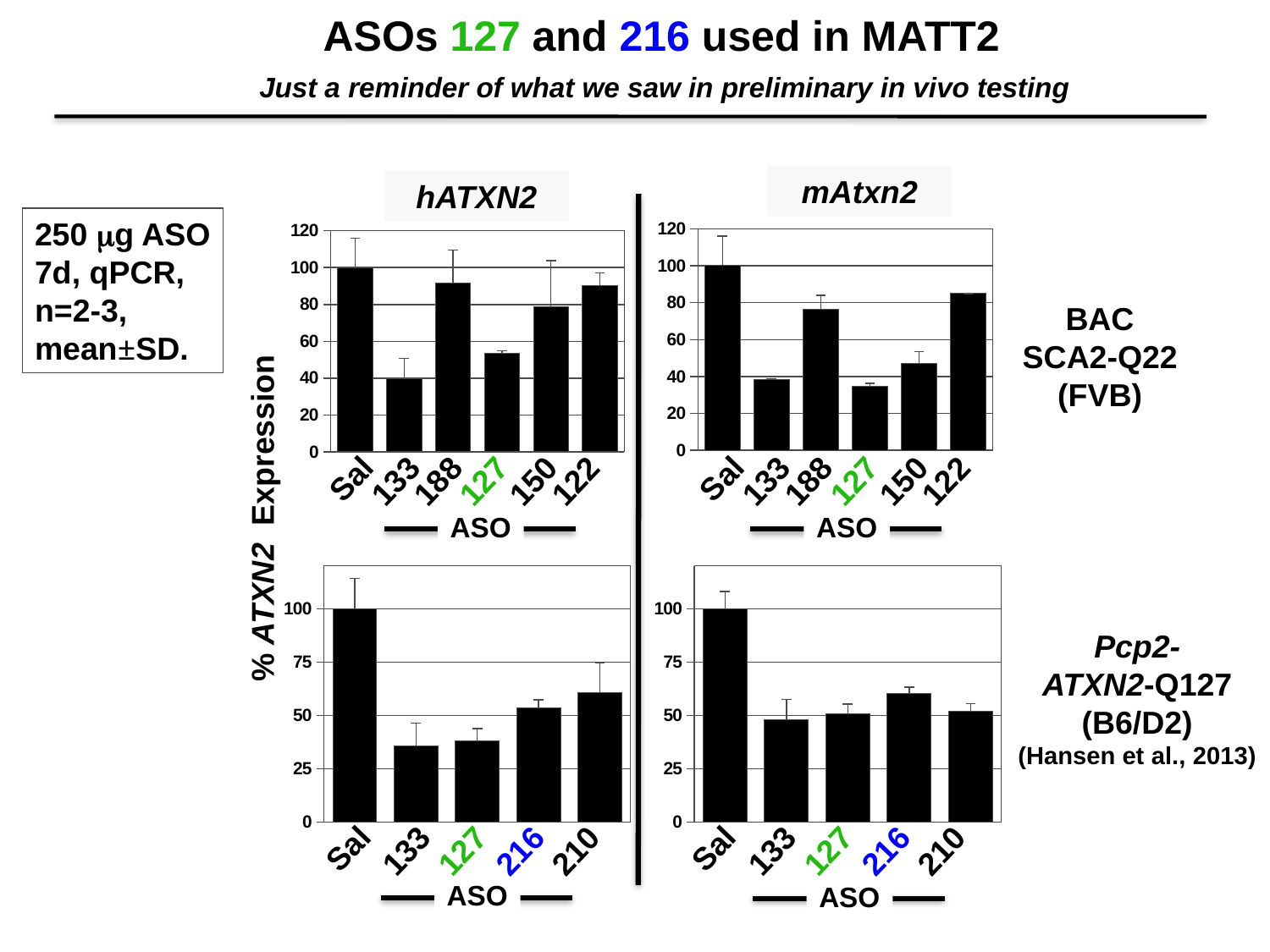
In the top-left hATXN2 chart (BAC SCA2-Q22), is the value for 188 greater or less than 80? greater In the bottom-right mAtxn2 chart (Pcp2-ATXN2-Q127), is the value for 216 greater or less than 50? greater What is the y-axis label shared by the charts on the slide? % ATXN2 Expression What kind of chart is the hATXN2 chart for BAC SCA2-Q22 (top left)? bar chart In the top-left hATXN2 chart (BAC SCA2-Q22), how many bars are plotted? 6 In the top-left hATXN2 chart (BAC SCA2-Q22), which category has the highest value? Sal In the bottom-left hATXN2 chart (Pcp2-ATXN2-Q127), how many bars are plotted? 5 In the top-right mAtxn2 chart (BAC SCA2-Q22), is the value for 150 greater or less than 60? less In the bottom-left hATXN2 chart (Pcp2-ATXN2-Q127), which is larger, the value for 210 or the value for 133? 210 In the top-right mAtxn2 chart (BAC SCA2-Q22), which is larger, the value for 188 or the value for 150? 188 In the top-left hATXN2 chart (BAC SCA2-Q22), what is the value for Sal? 100 In the top-left hATXN2 chart (BAC SCA2-Q22), which category has the lowest value? 133